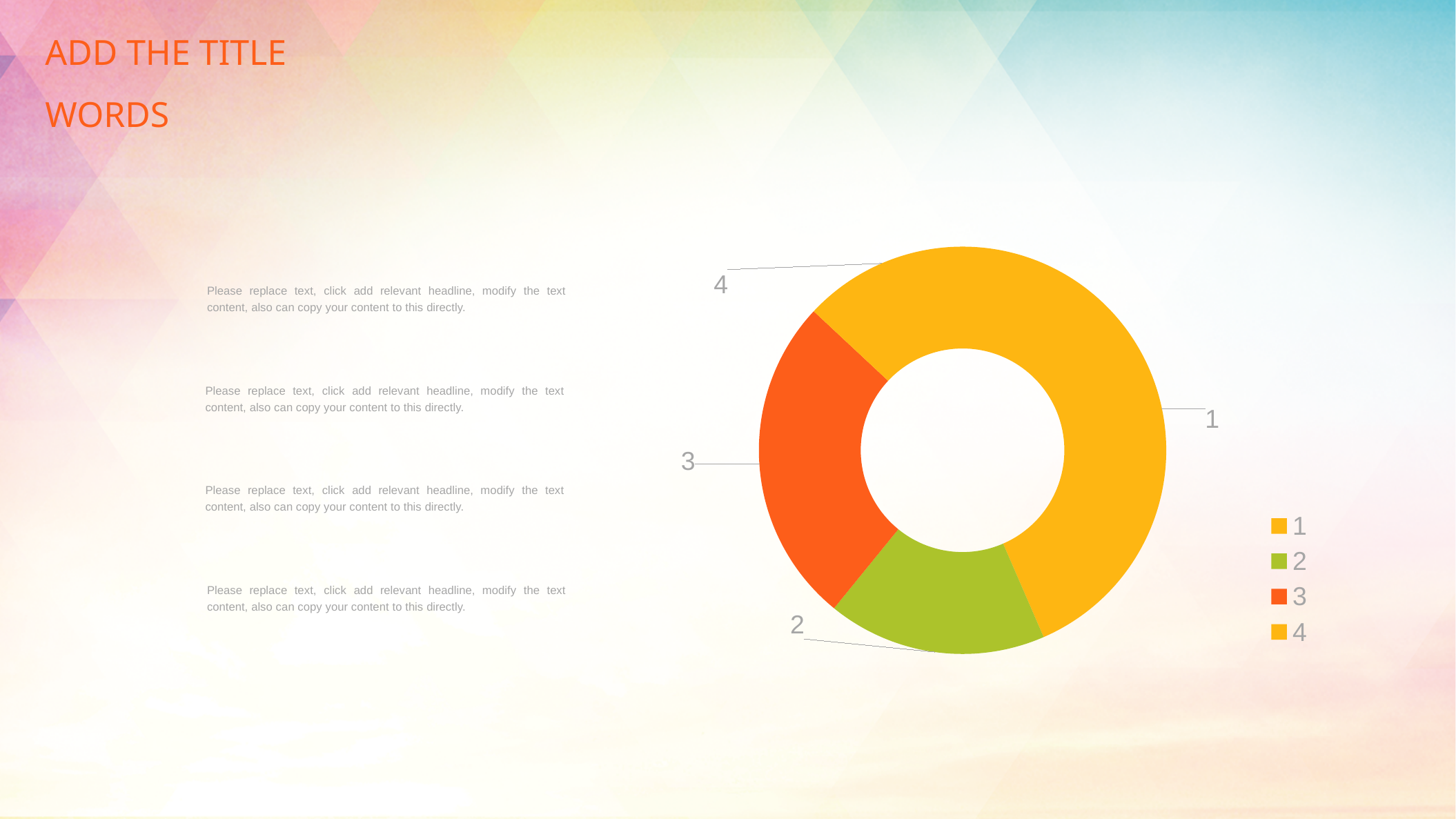
What kind of chart is shown on the slide? doughnut chart Which slice is larger, category 1 or category 4? 1 Which category has the largest slice in the doughnut chart? 1 Which slice is larger, category 1 or category 2? 1 How many entries does the legend list? 4 How many categories does the doughnut chart have? 4 Where is the legend positioned relative to the doughnut chart? to the right Which slice is larger, category 1 or category 3? 1 What colour is the slice for category 2? green